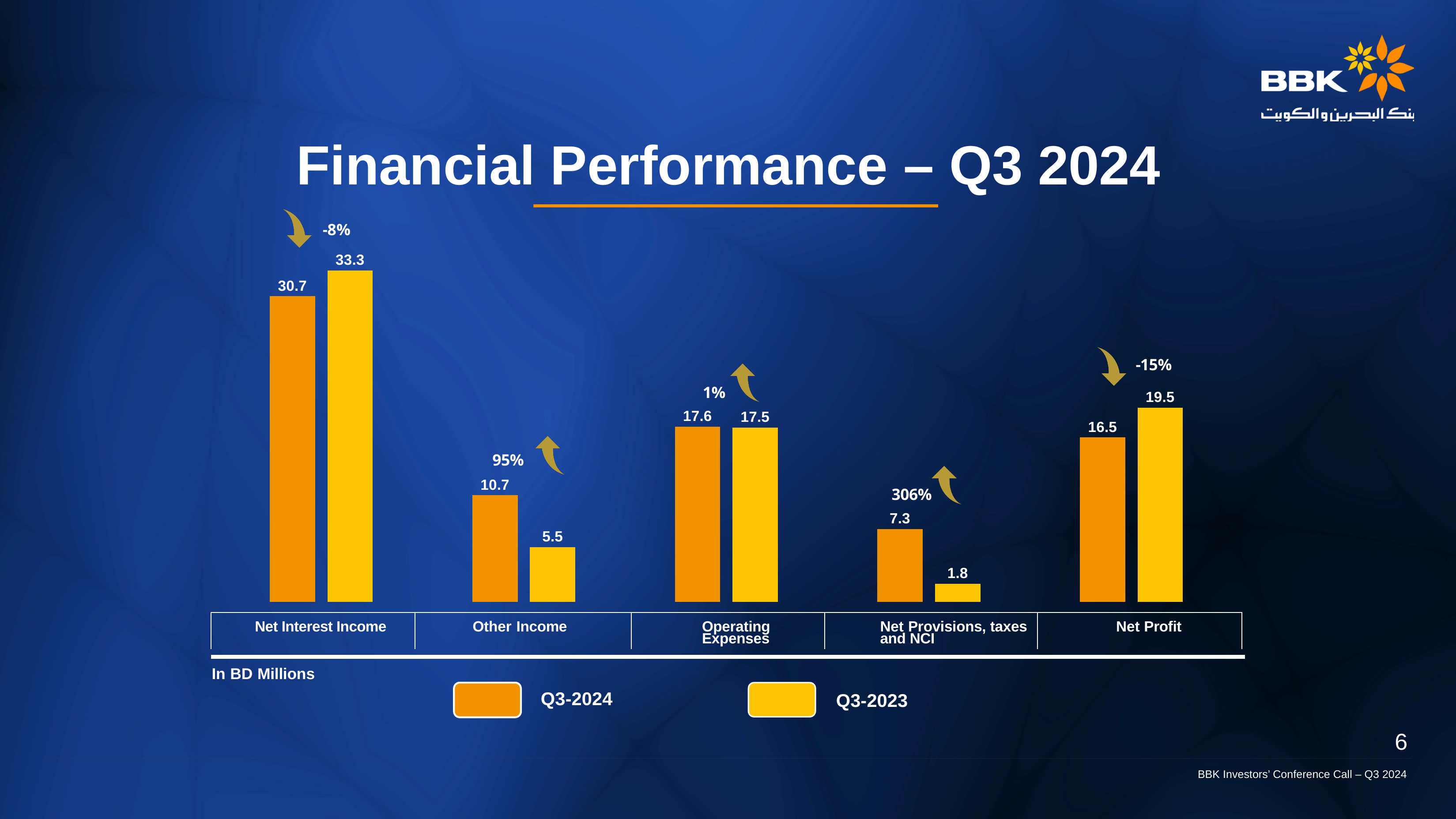
How many categories are shown on the x axis? 5 Which is larger for Other Income: the Q3-2024 value or the Q3-2023 value? Q3-2024 What percentage change is shown above the Net Provisions, taxes and NCI bars? 306% What is the Other Income value for Q3-2024? 10.7 What is the difference between the Q3-2023 and Q3-2024 values for Net Profit? 3.0 How many series does the legend list? 2 What is the Net Provisions, taxes and NCI value for Q3-2023? 1.8 What is the Net Interest Income value for Q3-2024? 30.7 What is the Net Profit value for Q3-2023? 19.5 What kind of chart is shown on the slide? Bar chart Which category has the lowest Q3-2023 value? Net Provisions, taxes and NCI Which category has the highest Q3-2024 value? Net Interest Income